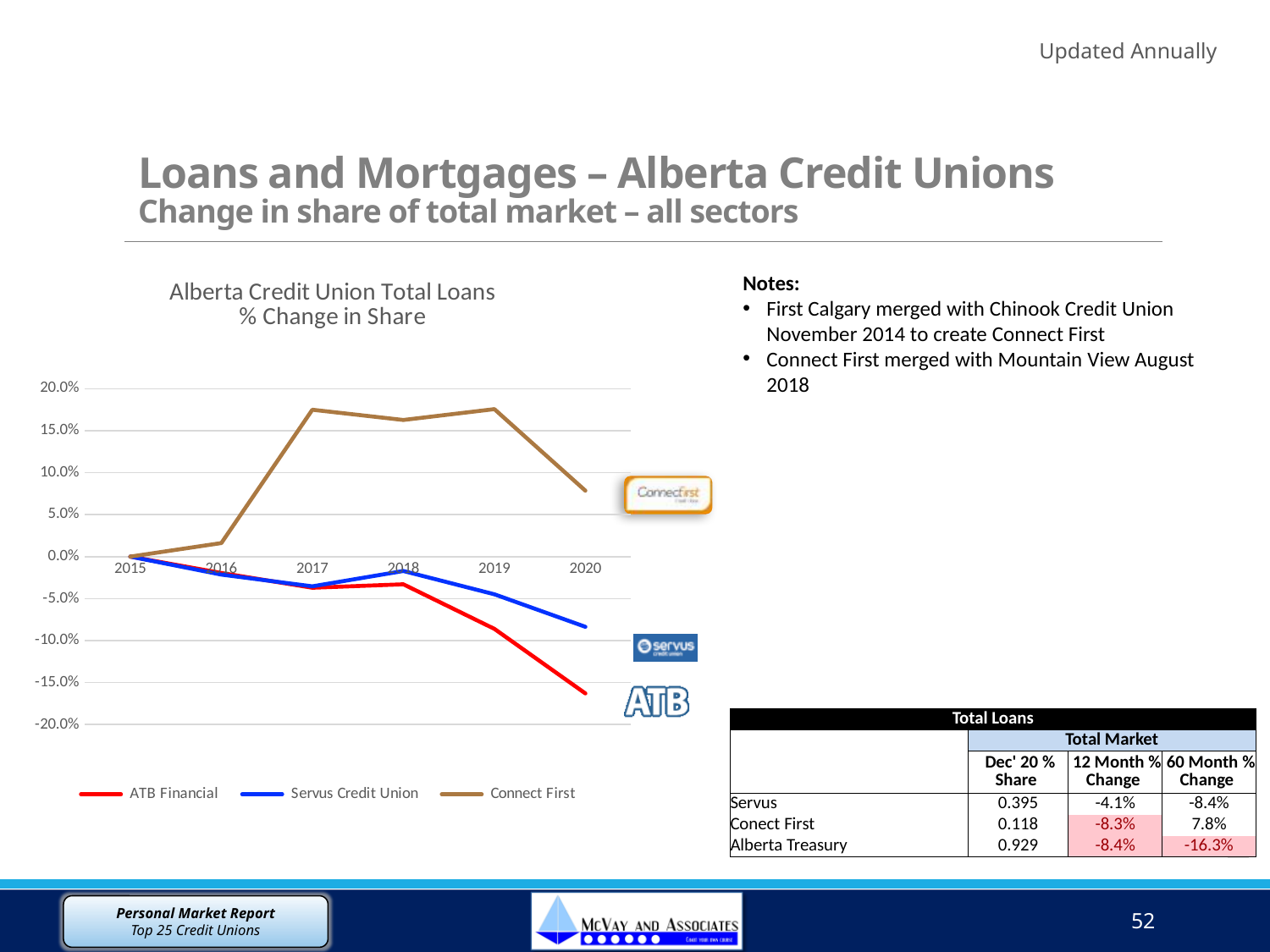
How many series does the legend of the chart list? 3 Which series has the lowest value in 2020? ATB Financial In 2019, which is higher: Servus Credit Union or ATB Financial? Servus Credit Union How many years are shown along the x axis of the chart? 6 What is the value for Connect First in 2015? 0.0% Is the value for Servus Credit Union in 2020 greater or less than -10.0%? greater Which series has the highest value in 2020? Connect First What kind of chart is shown on the slide? Line chart Is the value for Connect First in 2017 greater or less than 15.0%? greater Does the ATB Financial line rise or fall from 2015 to 2020? Falls Is the value for ATB Financial in 2020 greater or less than -15.0%? less What is the title of the chart? Alberta Credit Union Total Loans % Change in Share